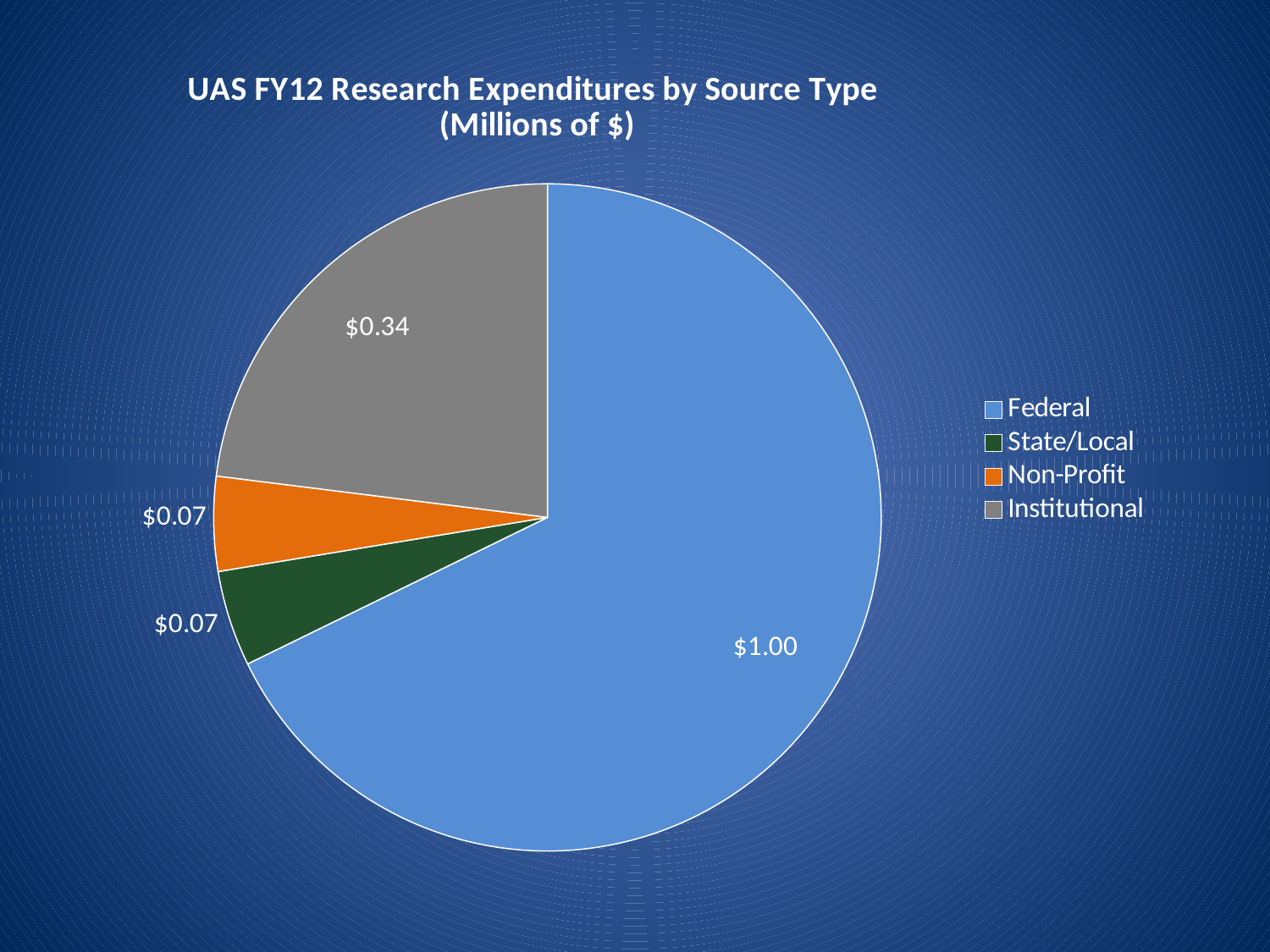
How many source types are shown in the pie chart? 4 What kind of chart is shown on the slide? Pie chart What is the difference between the Institutional and Non-Profit values? $0.27 What is the difference between the Federal and Institutional values? $0.66 What is the value for Non-Profit? $0.07 Which is larger, Institutional or Non-Profit? Institutional Which is larger, Federal or Institutional? Federal What is the value for State/Local? $0.07 What is the title of the chart? UAS FY12 Research Expenditures by Source Type (Millions of $) Which source type has the highest expenditure? Federal What is the value for Institutional? $0.34 What is the value for Federal? $1.00